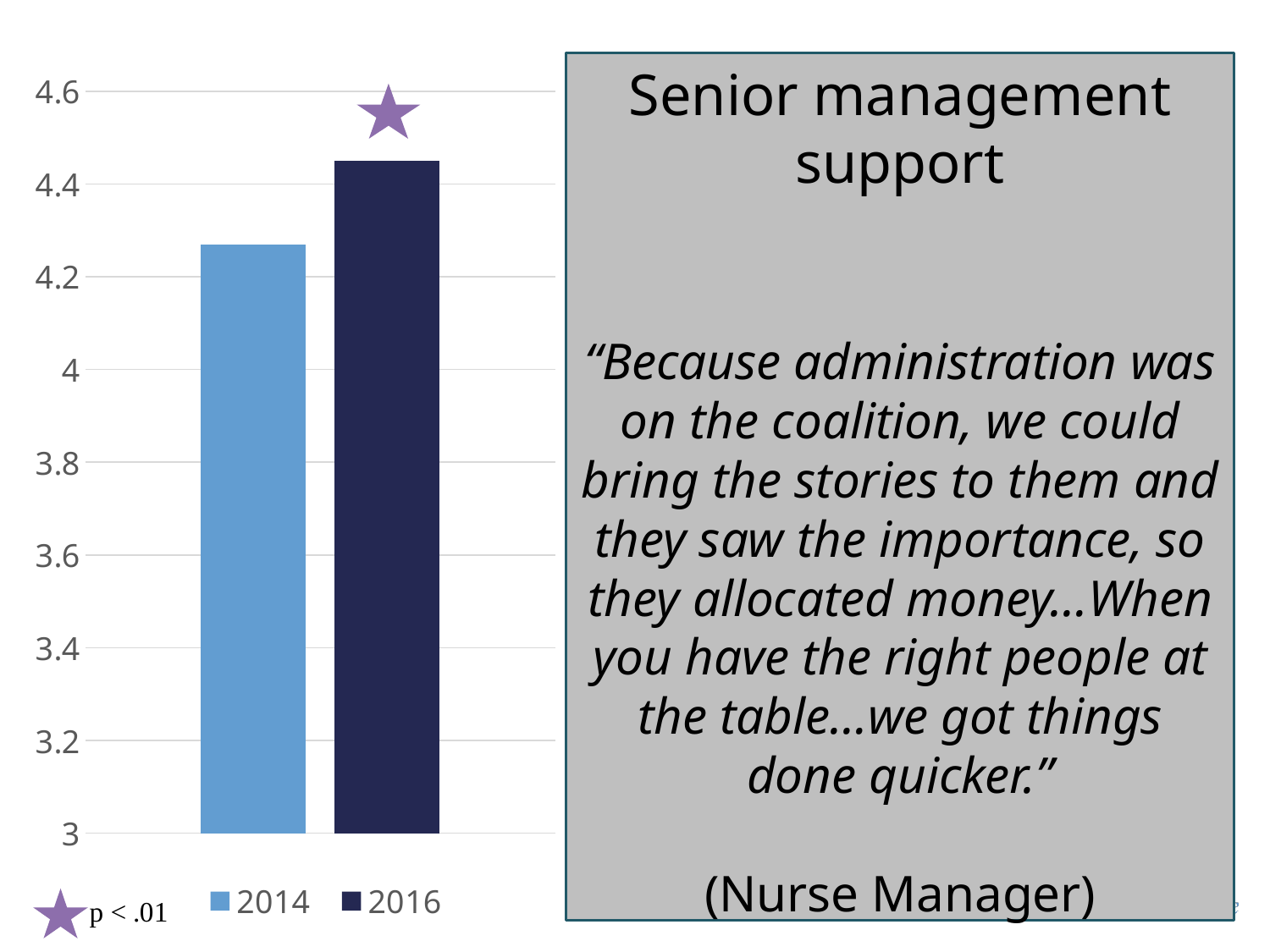
Is the value for 2016 greater or less than 4.6? less How many bars are plotted in the chart? 2 Is the value for 2014 greater or less than 4.2? greater Is the value for 2014 greater or less than 4.4? less Which year has the lowest value in the chart? 2014 Which series is shown in the dark navy colour in the legend? 2016 What kind of chart is shown on the slide? bar chart Which year has the higher bar, 2014 or 2016? 2016 Do the values rise or fall from 2014 to 2016? rise What does the purple star above the 2016 bar indicate, according to the key on the slide? p < .01 How many series does the chart legend list? 2